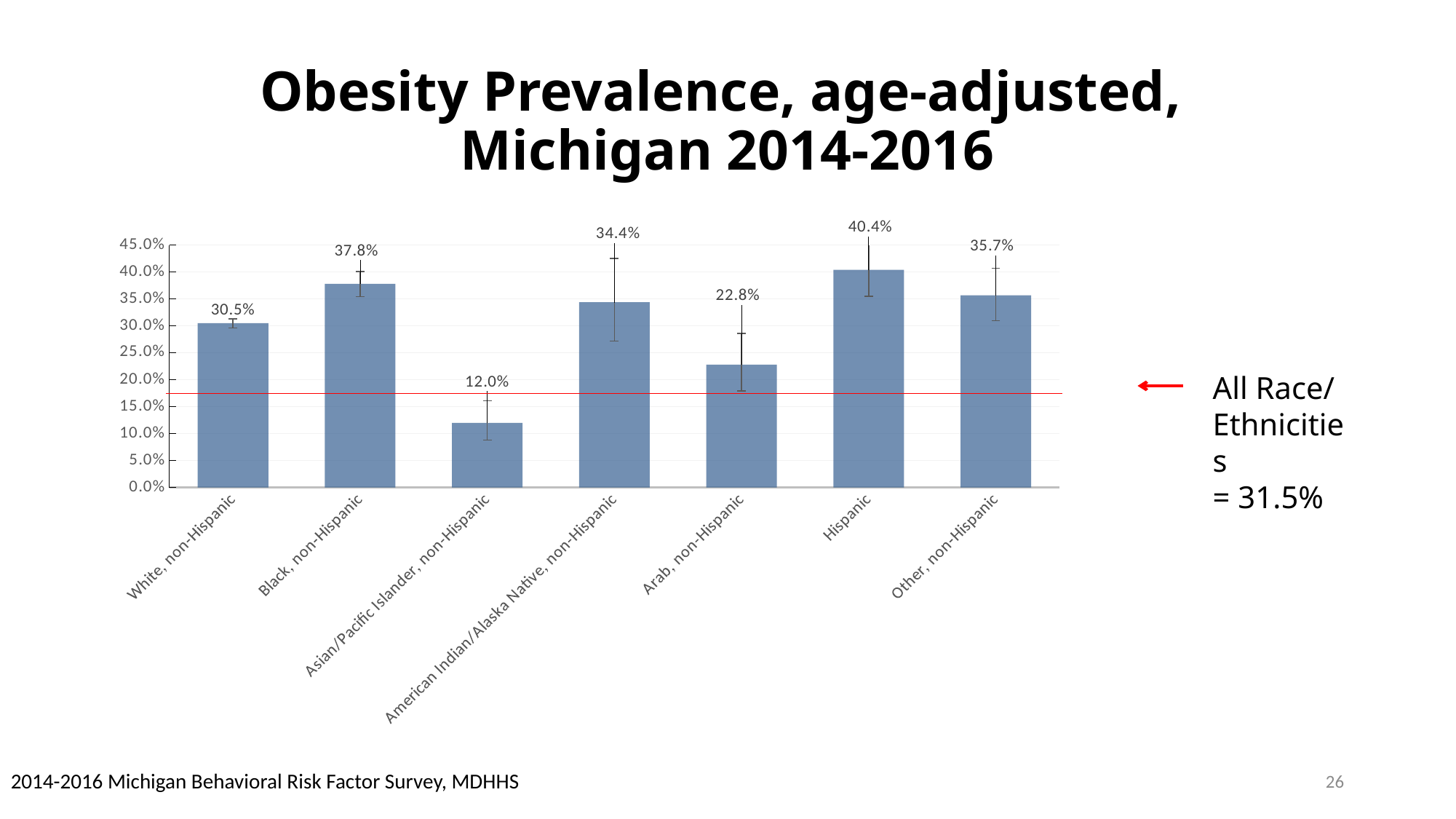
What is the obesity prevalence for Hispanic? 40.4% What is the obesity prevalence for all race/ethnicities combined, as noted on the slide? 31.5% What is the title of the chart? Obesity Prevalence, age-adjusted, Michigan 2014-2016 What type of chart is shown on the slide? Bar chart Which race/ethnicity group has the lowest obesity prevalence? Asian/Pacific Islander, non-Hispanic How many race/ethnicity categories are shown in the chart? 7 What is the obesity prevalence for Arab, non-Hispanic? 22.8% What is the obesity prevalence for Asian/Pacific Islander, non-Hispanic? 12.0% What is the difference in obesity prevalence between Black, non-Hispanic and White, non-Hispanic? 7.3% Which has a higher obesity prevalence, Other, non-Hispanic or American Indian/Alaska Native, non-Hispanic? Other, non-Hispanic What is the obesity prevalence for White, non-Hispanic? 30.5% Which race/ethnicity group has the highest obesity prevalence? Hispanic